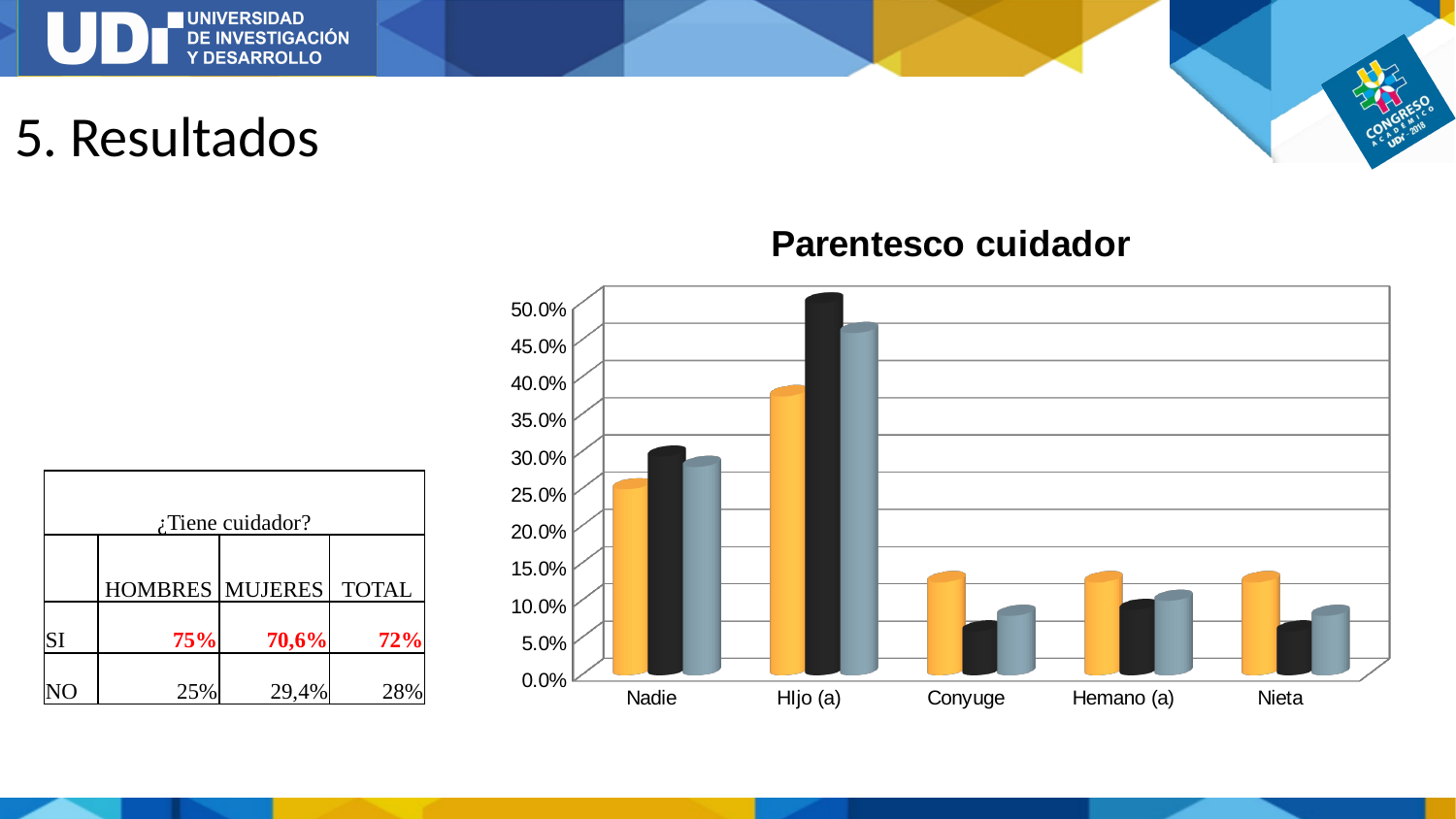
In the "Parentesco cuidador" chart, is the black bar for HIjo (a) greater or less than 45.0%? greater Which category in the "Parentesco cuidador" chart has the tallest orange bar? HIjo (a) In the "Parentesco cuidador" chart, is the black bar for Conyuge greater or less than 10.0%? less Which category in the "Parentesco cuidador" chart has the tallest bar overall? HIjo (a) What kind of chart is shown under the title "Parentesco cuidador"? bar chart In the "Parentesco cuidador" chart, which is larger: the black bar for Nadie or the black bar for HIjo (a)? HIjo (a) In the "Parentesco cuidador" chart, is the orange bar for Conyuge greater or less than 15.0%? less What is the highest tick value shown on the y axis of the "Parentesco cuidador" chart? 50.0% How many bars are plotted for each category in the "Parentesco cuidador" chart? 3 In the "Parentesco cuidador" chart, which is larger for Conyuge: the orange bar or the black bar? the orange bar How many categories are shown on the x axis of the "Parentesco cuidador" chart? 5